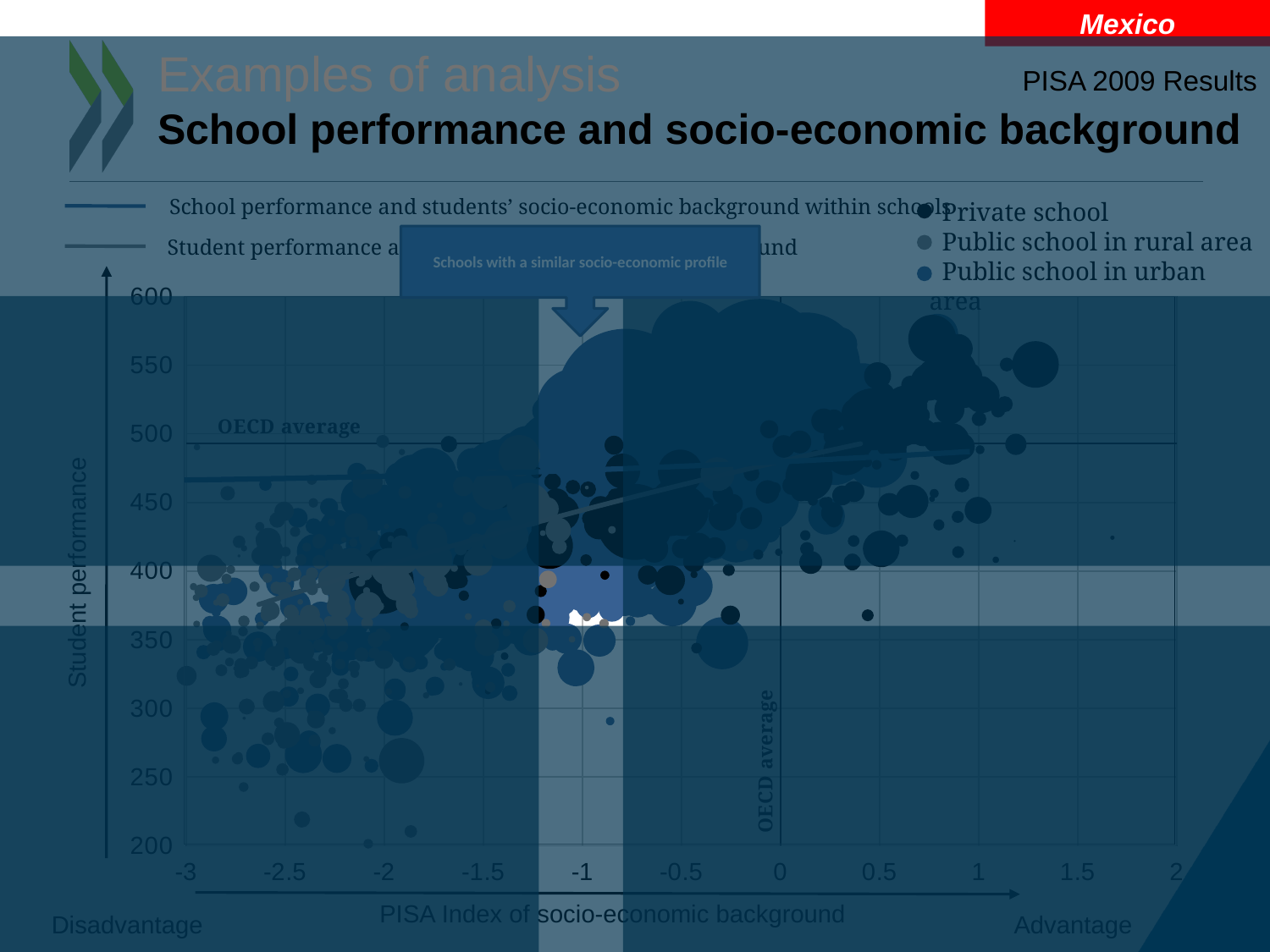
Which three school types are listed in the chart's legend? Private school; Public school in rural area; Public school in urban area Does student performance generally rise or fall as the PISA index of socio-economic background increases along the x axis? rise How many series does the chart's legend list? 3 What kind of chart is shown on the slide? Scatter (bubble) chart What is the label of the vertical axis of the chart? Student performance